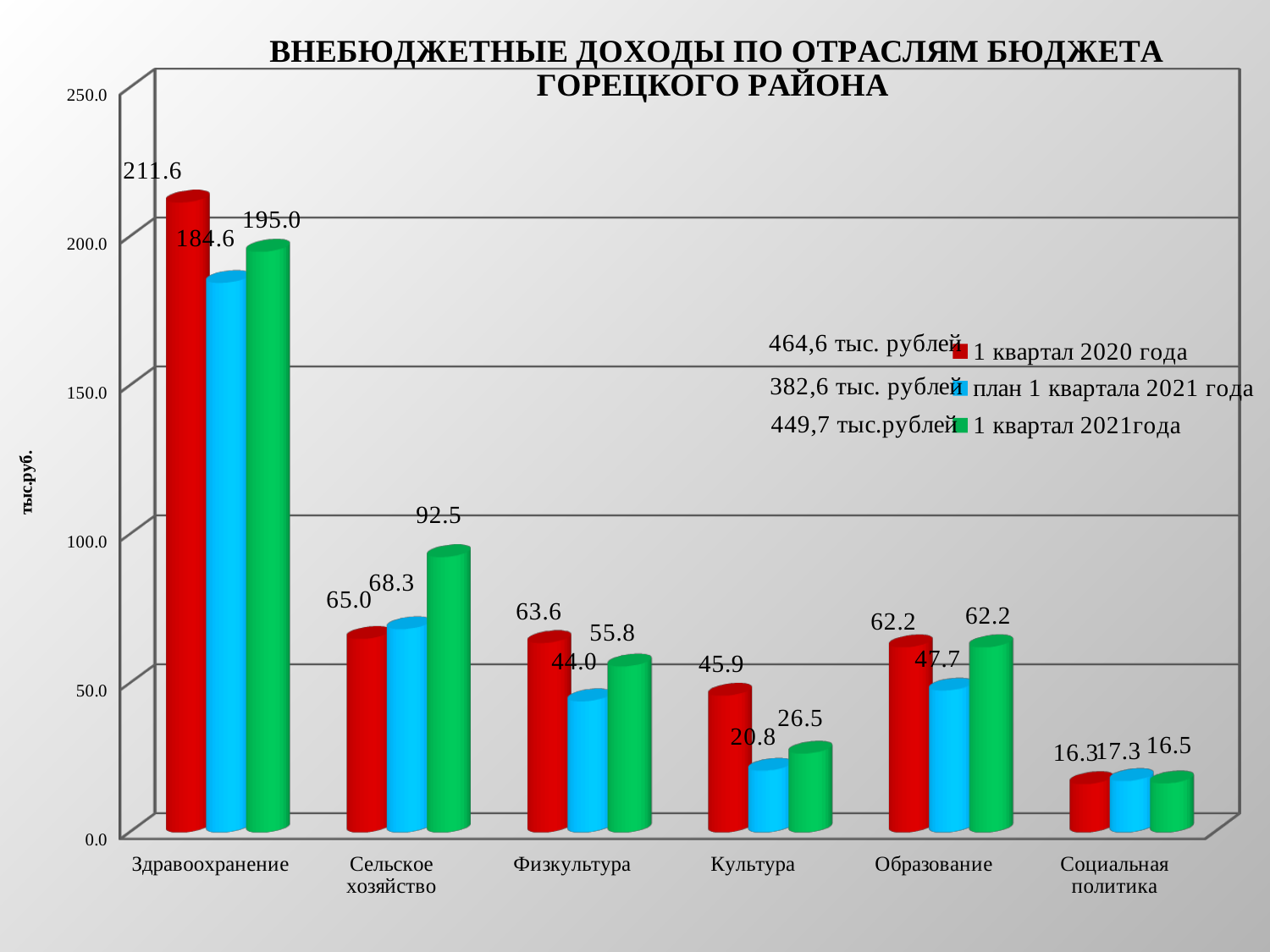
Which category has the highest value in the series 1 квартал 2020 года? Здравоохранение How many categories are shown on the x axis? 6 What is the axis title on the vertical axis? тыс.руб. What is the value for Здравоохранение in the series 1 квартал 2020 года? 211.6 What kind of chart is shown on the slide? bar chart How many series does the legend list? 3 Which category has the lowest value in the series 1 квартал 2021года? Социальная политика For Физкультура, which is larger: the value for 1 квартал 2020 года or the value for план 1 квартала 2021 года? 1 квартал 2020 года What is the value for Культура in the series план 1 квартала 2021 года? 20.8 What is the value for Сельское хозяйство in the series 1 квартал 2021года? 92.5 What is the difference between the 1 квартал 2020 года value and the 1 квартал 2021года value for Здравоохранение? 16.6 Is the value for Сельское хозяйство in the series 1 квартал 2021года greater or less than 100.0? less